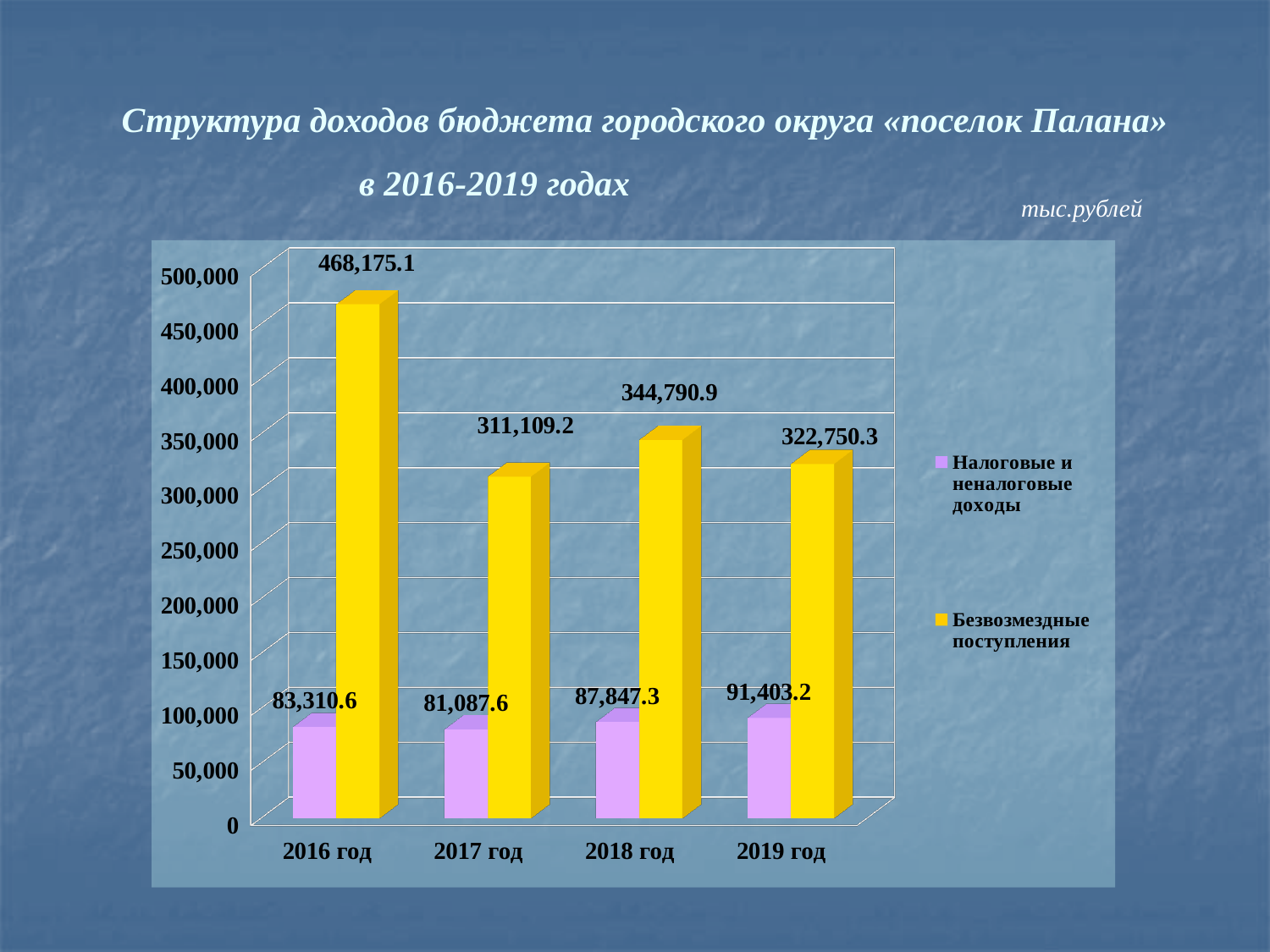
In which year is Налоговые и неналоговые доходы the lowest? 2017 год In which year is Безвозмездные поступления the highest? 2016 год What is the difference between Налоговые и неналоговые доходы in 2019 год and 2016 год? 8,092.6 Which is larger: Безвозмездные поступления in 2018 год or in 2019 год? 2018 год What kind of chart is shown on the slide? Bar chart What is the difference between Безвозмездные поступления in 2016 год and 2017 год? 157,065.9 How many series does the legend list? 2 What is the value of Налоговые и неналоговые доходы for 2017 год? 81,087.6 What is the value of Безвозмездные поступления for 2018 год? 344,790.9 How many years are shown on the x axis? 4 What is the value of Налоговые и неналоговые доходы for 2019 год? 91,403.2 What is the value of Безвозмездные поступления for 2016 год? 468,175.1